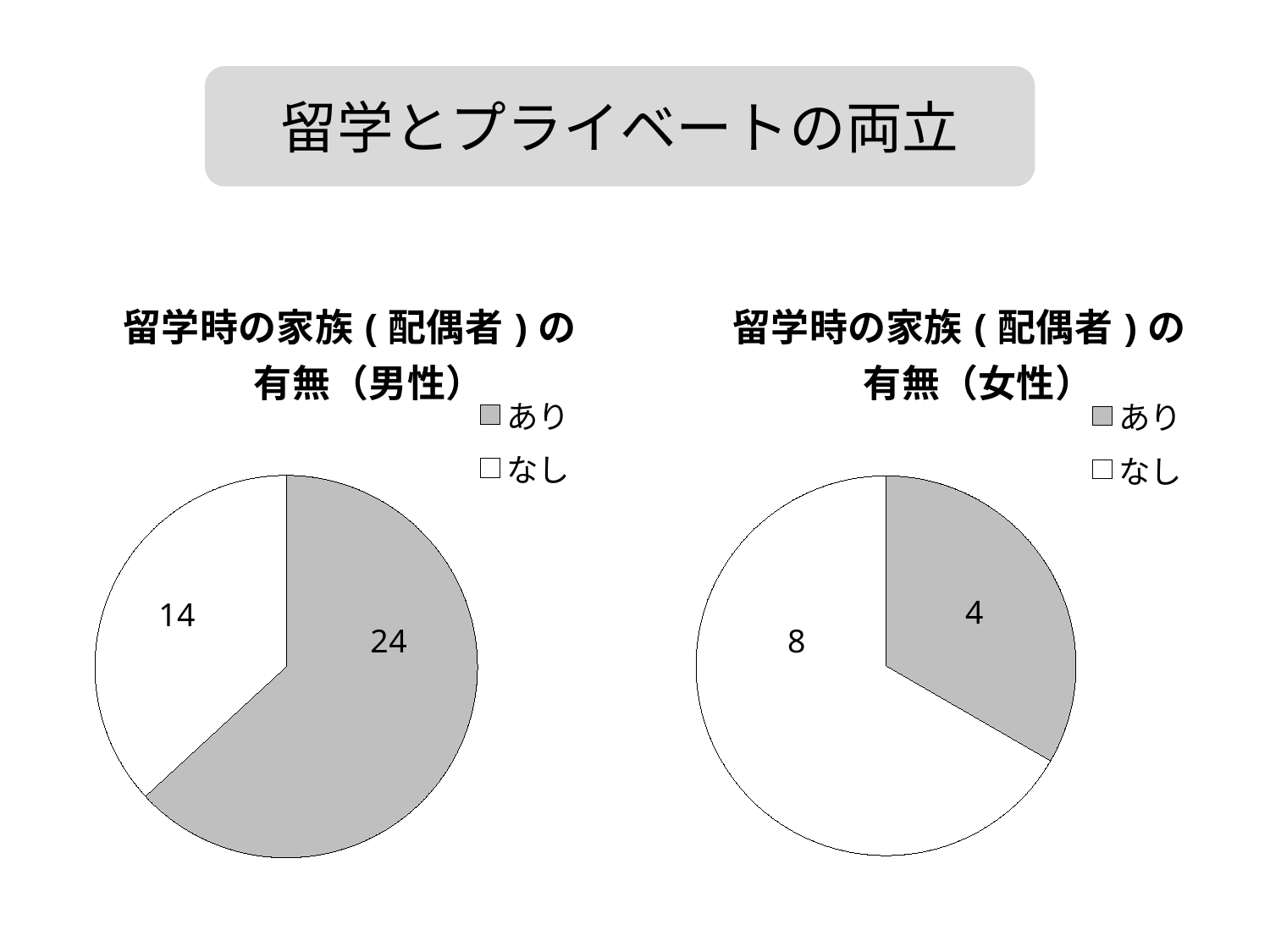
In the left pie chart (男性), what is the value for なし? 14 In the right pie chart (女性), which category has the smaller value? あり Is the value for あり larger in the left pie chart (男性) or the right pie chart (女性)? left (男性) In the left pie chart (男性), which category has the larger value? あり In the left pie chart (男性), what is the difference between あり and なし? 10 In the right pie chart (女性), what is the difference between なし and あり? 4 How many entries does the legend of the left pie chart (男性) list? 2 In the right pie chart (女性), what is the value for あり? 4 In the right pie chart (女性), what fraction of the pie does あり represent? one third In the left pie chart (男性), what is the value for あり? 24 What type of chart is used on this slide? pie chart In the right pie chart (女性), what is the value for なし? 8